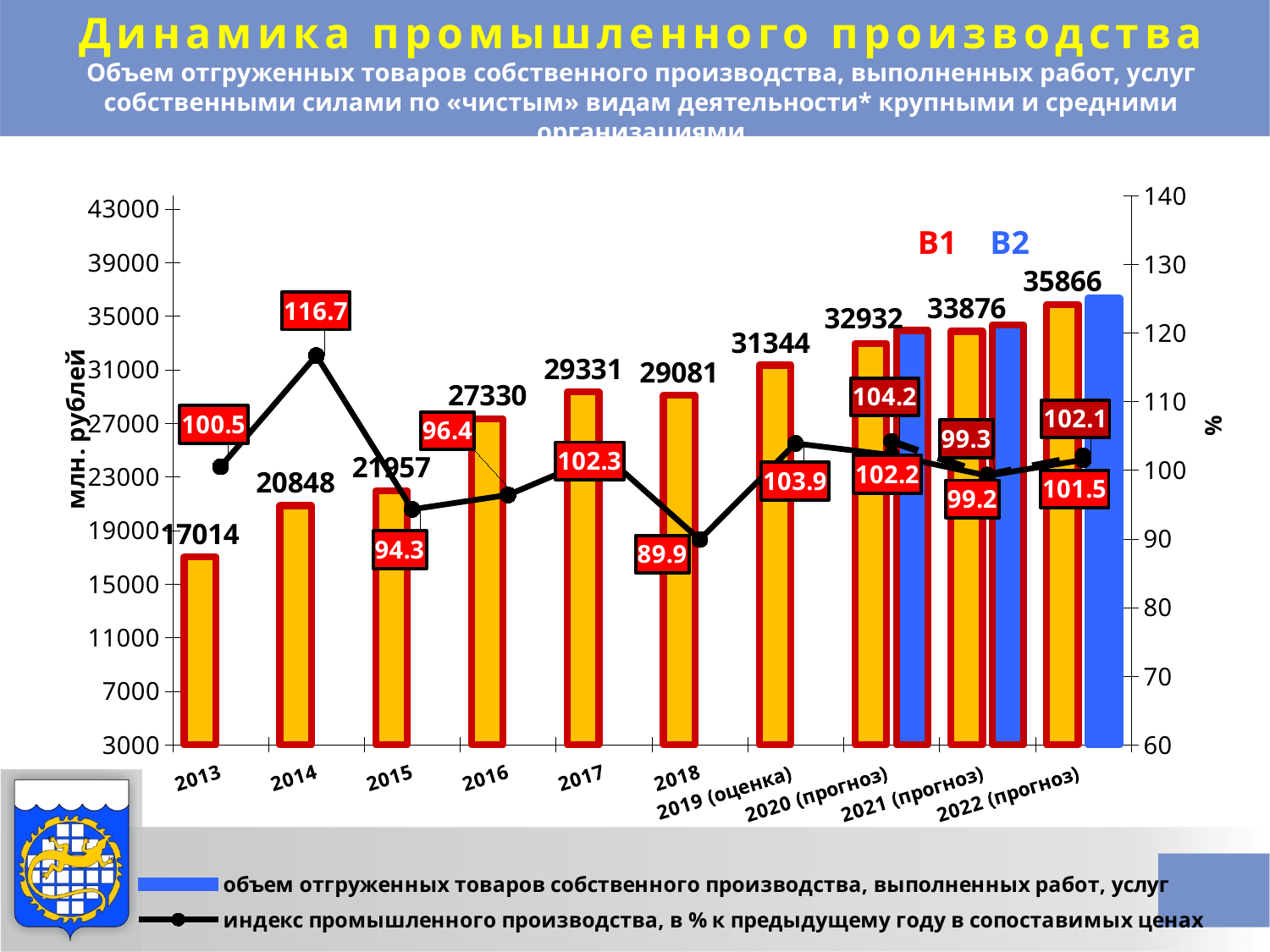
What is the value of the shipped goods volume bar for 2019 (оценка)? 31344 Do the shipped goods volume bars rise or fall from 2013 to 2017? rise What is the industrial production index value for 2018? 89.9 Which year has the larger shipped goods volume bar, 2015 or 2016? 2016 What is the value of the shipped goods volume bar for 2013? 17014 What is the difference between the shipped goods volume for 2017 and for 2018? 250 In which year is the industrial production index line at its highest? 2014 What is the value of the shipped goods volume bar for 2016? 27330 In which year is the industrial production index line at its lowest? 2018 What is the industrial production index value for 2014? 116.7 How many series does the legend list? 2 How many years are shown on the x axis? 10